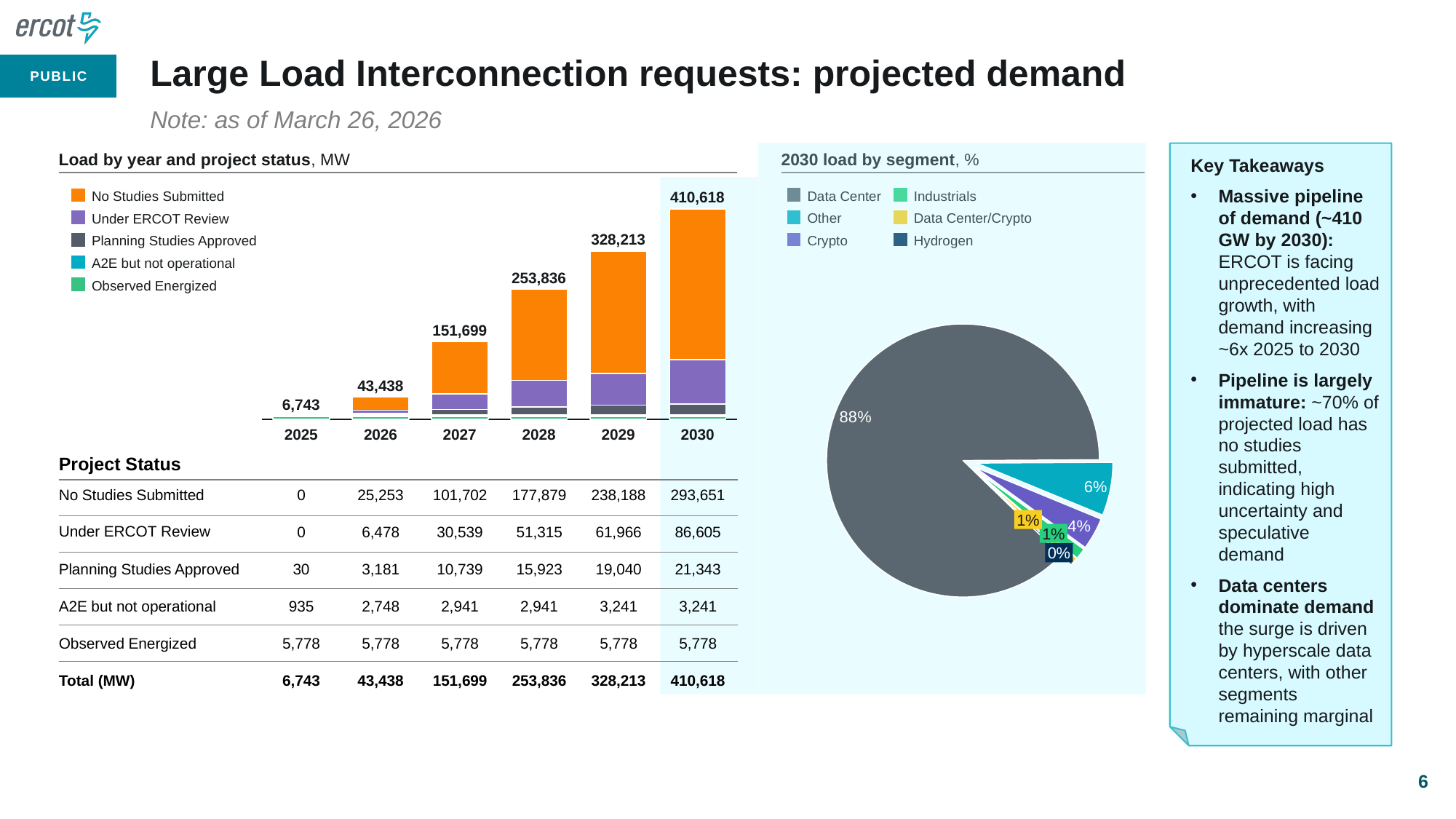
In the '2030 load by segment' pie chart, what share does Data Center have? 88% In the '2030 load by segment' pie chart, which segment has the largest share? Data Center In the 'Load by year and project status' chart, what is the total load for 2027? 151,699 How many segments does the legend of the '2030 load by segment' pie chart list? 6 In the 'Load by year and project status' chart, do the total values rise or fall from 2025 to 2030? rise How many series does the legend of the 'Load by year and project status' chart list? 5 In the 'Load by year and project status' chart, what is the 'No Studies Submitted' value for 2029? 238,188 In the '2030 load by segment' pie chart, which is larger, Other or Crypto? Other In the 'Load by year and project status' chart, which year has the lowest total load? 2025 In the 'Load by year and project status' chart, what is the total load for 2030? 410,618 What kind of chart is the 'Load by year and project status' chart? stacked bar chart In the 'Load by year and project status' chart, what is the difference between the 2030 total and the 2029 total? 82,405